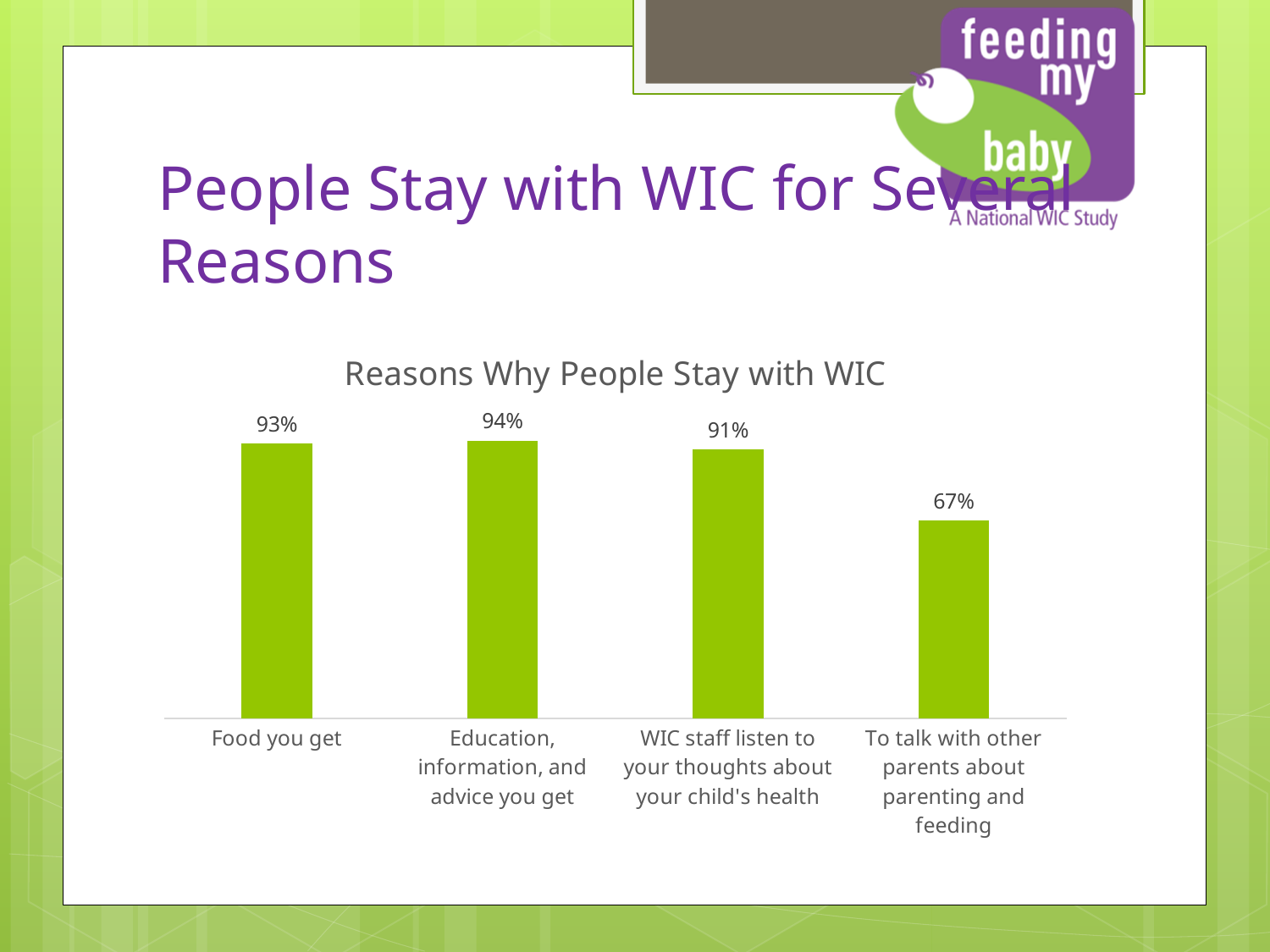
What percentage of people cite "Food you get" as a reason they stay with WIC? 93% What is the value for "To talk with other parents about parenting and feeding"? 67% Which reason has the highest percentage? Education, information, and advice you get What is the difference between "Education, information, and advice you get" and "WIC staff listen to your thoughts about your child's health"? 3% What percentage is shown for "WIC staff listen to your thoughts about your child's health"? 91% Which reason has the lowest percentage? To talk with other parents about parenting and feeding Which is larger: the value for "Food you get" or the value for "To talk with other parents about parenting and feeding"? Food you get What is the difference between the values for "Food you get" and "To talk with other parents about parenting and feeding"? 26% What is the title of the chart? Reasons Why People Stay with WIC What type of chart is shown on the slide? Bar chart How many reasons (categories) are shown in the chart? 4 What is the value for "Education, information, and advice you get"? 94%